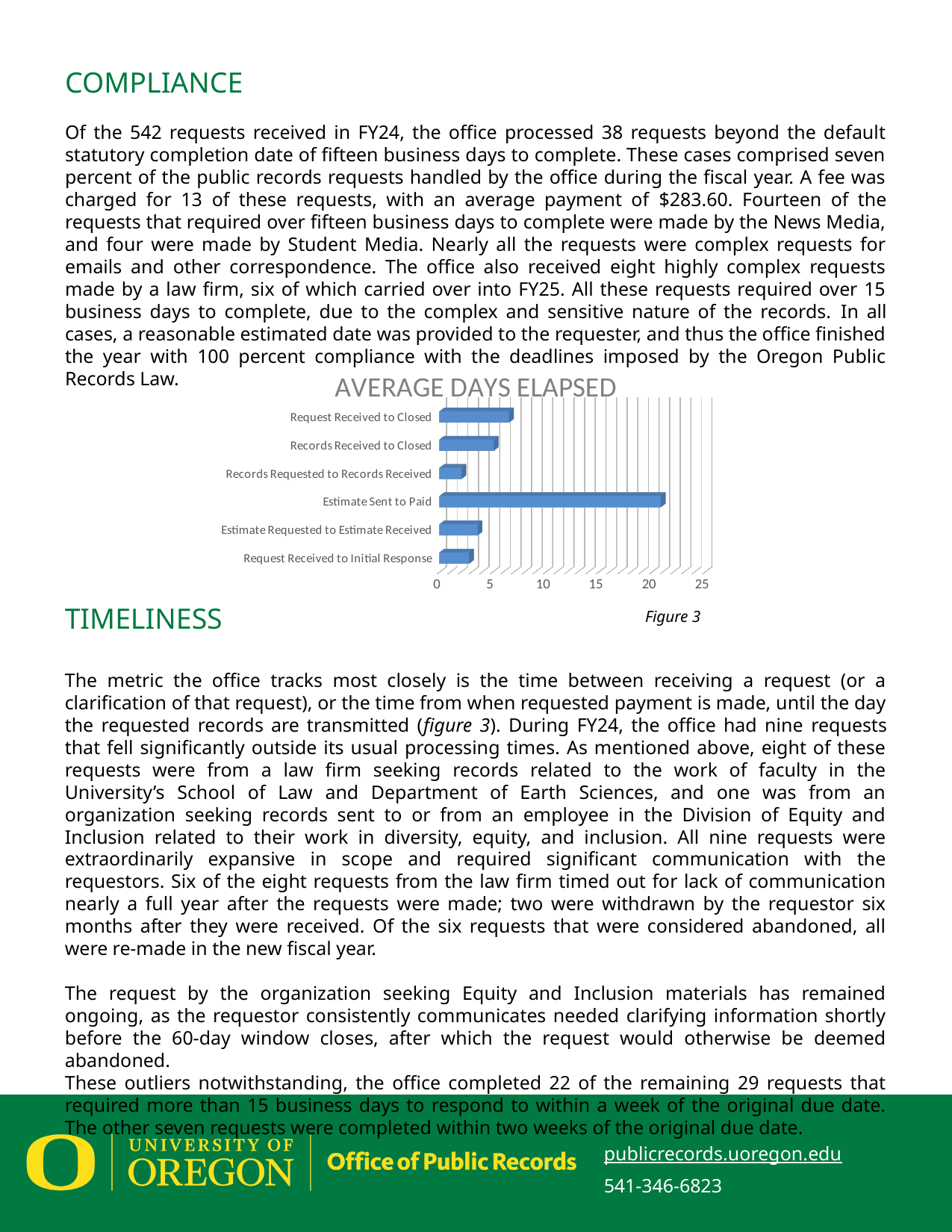
What figure number is given for the chart? Figure 3 Is the value for Estimate Sent to Paid greater or less than 15? greater Is the value for Request Received to Initial Response greater or less than 5? less Is the value for Records Requested to Records Received greater or less than 5? less What kind of chart is shown on the slide? bar chart Which category has the highest average days elapsed? Estimate Sent to Paid Which is larger, the value for Estimate Sent to Paid or the value for Request Received to Closed? Estimate Sent to Paid Which is larger, the value for Request Received to Closed or the value for Records Received to Closed? Request Received to Closed How many categories are plotted in the chart? 6 What is the title of the chart? AVERAGE DAYS ELAPSED